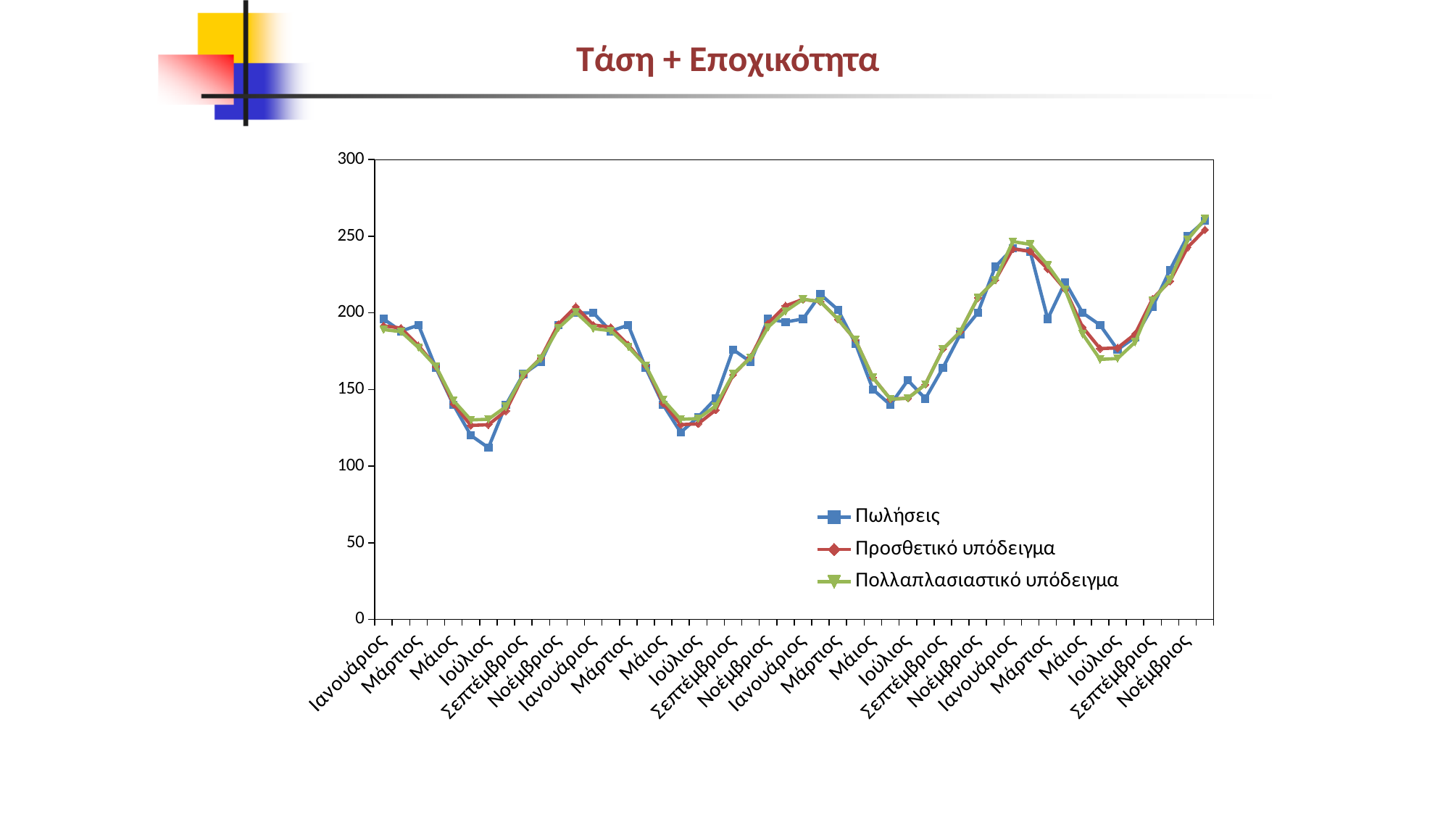
Is the lowest value of Πωλήσεις greater or less than 150? less Is the value of Πωλήσεις at the first Ιούλιος greater or less than 150? less Is the value of Πωλήσεις at the last Νοέμβριος greater or less than 200? greater How many times does the label Ιανουάριος appear on the x axis? 4 What is the highest value shown on the y axis? 300 What is the title of the slide's chart? Τάση + Εποχικότητα Is the value of Πωλήσεις at the first Ιανουάριος larger or smaller than at the first Ιούλιος? larger What kind of chart is shown on the slide? line chart How many series does the legend list? 3 Overall, do the Πωλήσεις values rise or fall from the first Ιανουάριος to the last Νοέμβριος? rise Which series is drawn in blue with square markers? Πωλήσεις